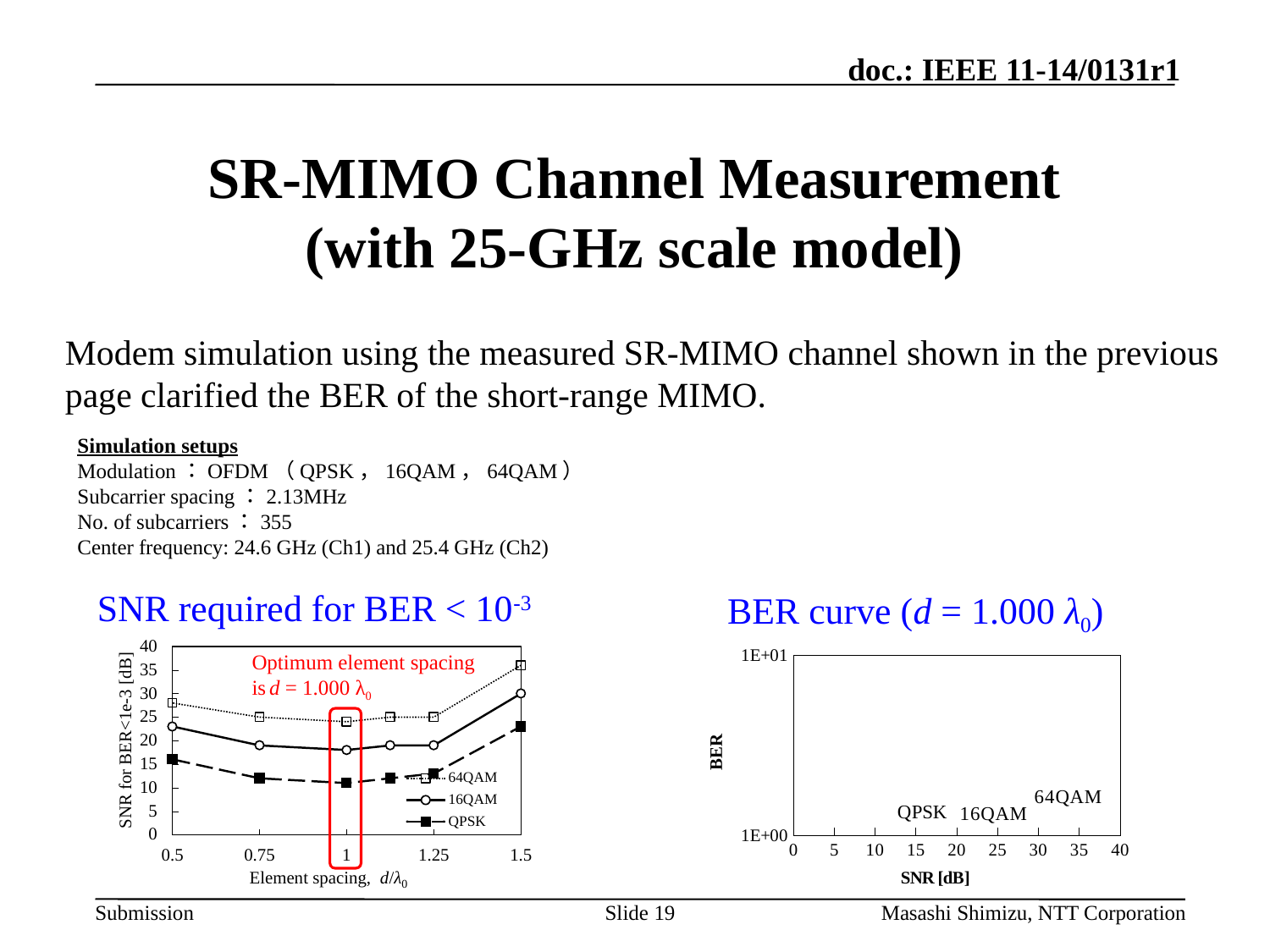
In the 'SNR required for BER < 10-3' chart, how many series does the legend list? 3 In the 'SNR required for BER < 10-3' chart, do the QPSK values rise or fall between element spacing 1.25 and 1.5? rise In the 'SNR required for BER < 10-3' chart, what kind of chart is shown? line chart In the 'SNR required for BER < 10-3' chart, which series has the highest SNR at element spacing 0.5? 64QAM In the 'SNR required for BER < 10-3' chart, is the 64QAM value at element spacing 0.5 greater or less than 25? greater In the 'SNR required for BER < 10-3' chart, is the QPSK value at element spacing 1 greater or less than 15? less In the 'SNR required for BER < 10-3' chart, at which element spacing is the 64QAM SNR highest? 1.5 In the 'SNR required for BER < 10-3' chart, which is larger at element spacing 1: the 16QAM value or the QPSK value? 16QAM In the 'BER curve (d = 1.000 λ0)' chart, what is the label of the x axis? SNR [dB] In the 'SNR required for BER < 10-3' chart, is the 16QAM value at element spacing 1.5 greater or less than 25? greater In the 'SNR required for BER < 10-3' chart, which series has the lowest SNR at element spacing 1.5? QPSK In the 'SNR required for BER < 10-3' chart, what optimum element spacing does the annotation state? d = 1.000 λ0